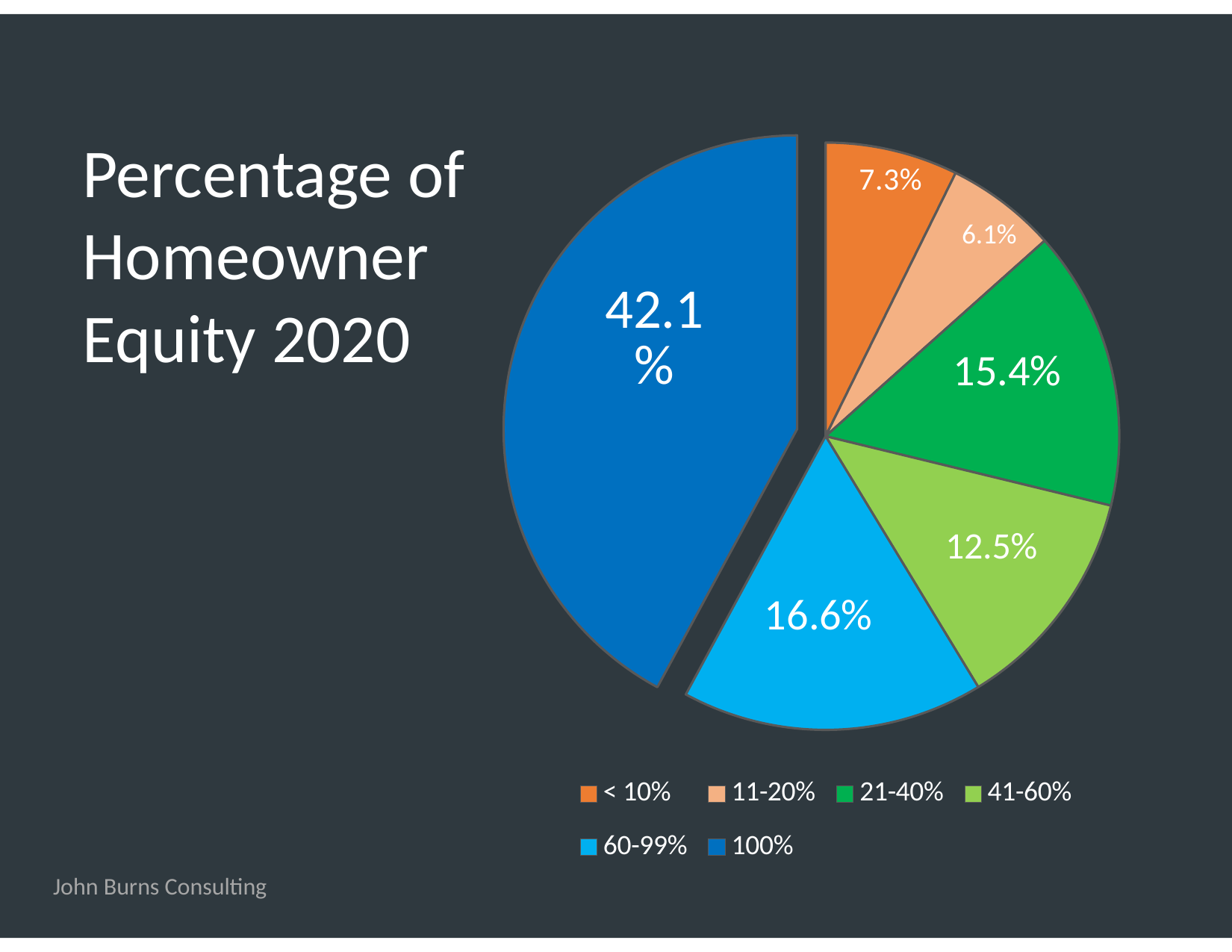
How many categories does the pie chart have? 6 What is the value for the 11-20% equity category? 6.1% What is the value for the 21-40% equity category? 15.4% What type of chart is shown on the slide? pie chart What is the difference between the 60-99% and 41-60% categories? 4.1% Which equity category has the largest share of the pie? 100% What is the title of the chart? Percentage of Homeowner Equity 2020 Which equity category has the smallest share of the pie? 11-20% What percentage of homeowners have 100% equity? 42.1% Which is larger, the 21-40% category or the 41-60% category? 21-40% What is the value for the 60-99% equity category? 16.6% What is the value for the < 10% equity category? 7.3%